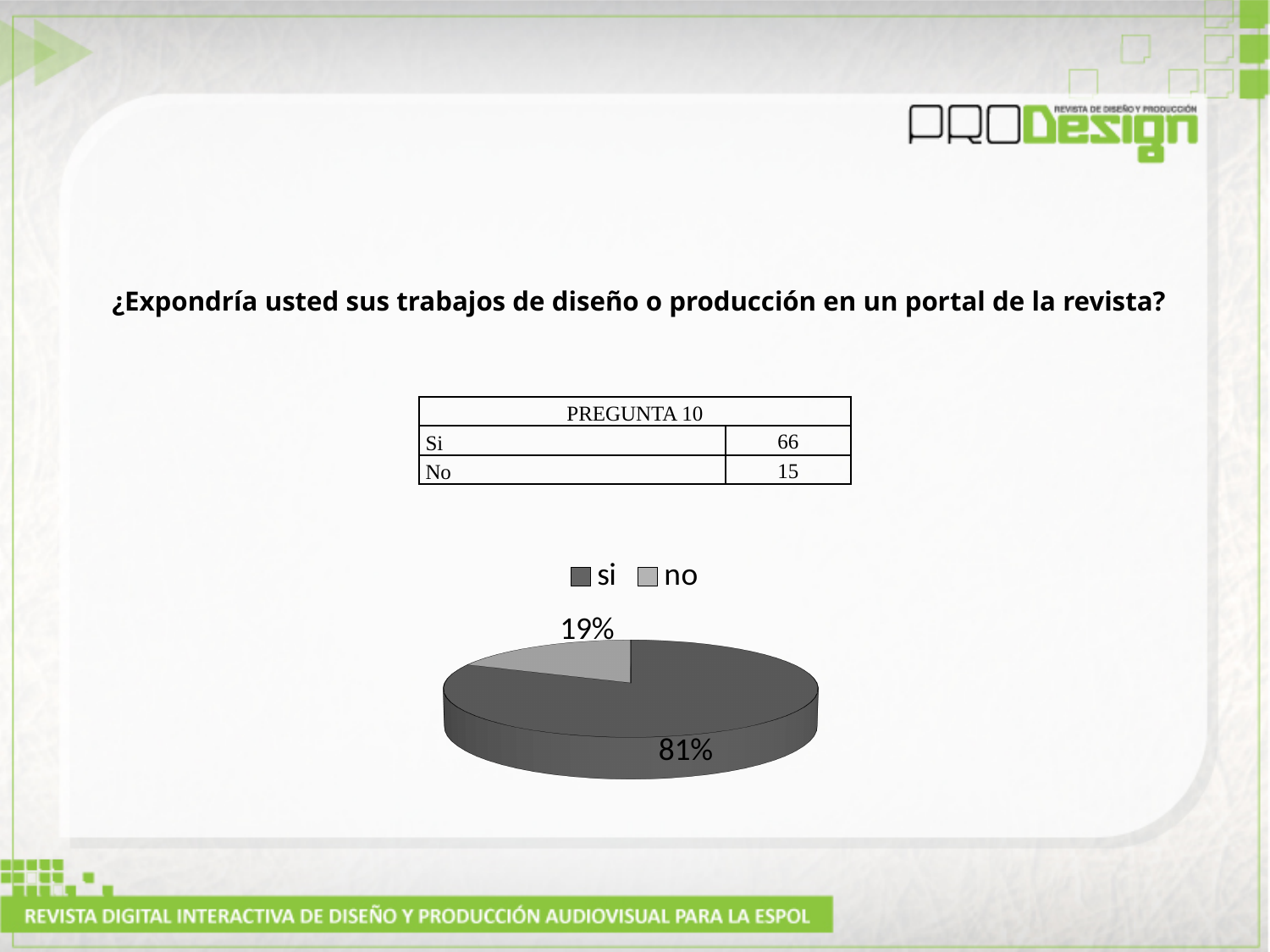
What percentage does the 'si' slice show in the pie chart? 81% Where is the legend positioned relative to the pie chart? above the pie How many slices does the pie chart have? 2 What percentage does the 'no' slice show in the pie chart? 19% How many entries does the legend of the pie chart list? 2 Which slice of the pie chart is the smallest? no What share of the pie does the 'no' slice represent? 19% What kind of chart is shown on the slide? pie chart Which is larger in the pie chart, 'si' or 'no'? si Which legend entry is shown in the lighter grey colour? no Which slice of the pie chart is the largest? si What is the difference in percentage points between the 'si' and 'no' slices? 62